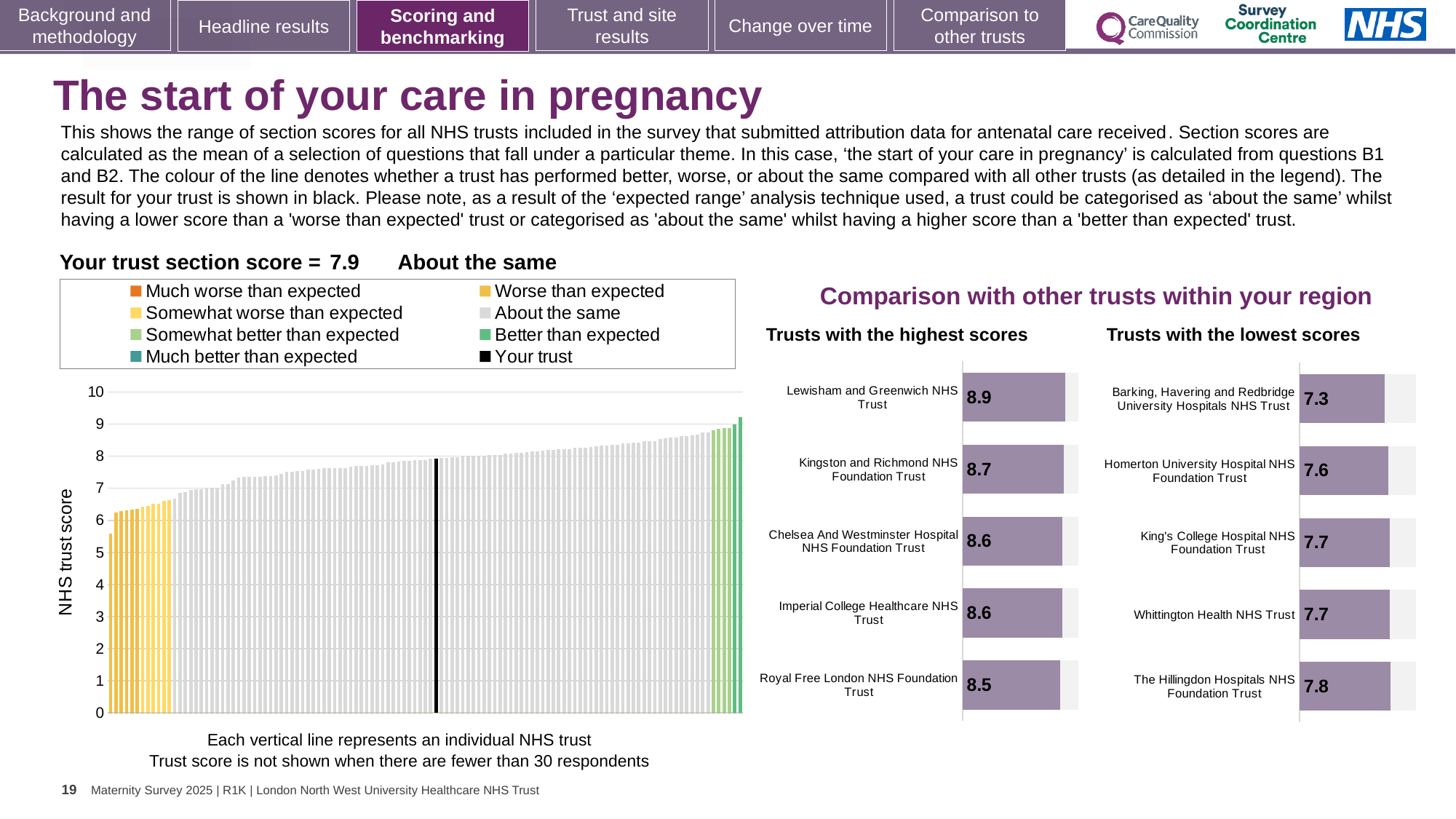
What kind of chart is the large chart on the left showing NHS trust scores? bar chart In the 'Trusts with the highest scores' chart, how many trusts are shown? 5 How many entries does the legend above the large chart on the left list? 8 In the 'Trusts with the highest scores' chart, what is the score for Lewisham and Greenwich NHS Trust? 8.9 In the large chart on the left, do the trust scores rise or fall from left to right? rise In the large chart on the left, what is the section score for your trust? 7.9 In the 'Trusts with the lowest scores' chart, which has the larger score: Homerton University Hospital NHS Foundation Trust or The Hillingdon Hospitals NHS Foundation Trust? The Hillingdon Hospitals NHS Foundation Trust In the 'Trusts with the lowest scores' chart, what is the score for Barking, Havering and Redbridge University Hospitals NHS Trust? 7.3 In the 'Trusts with the highest scores' chart, what is the difference between the scores of Lewisham and Greenwich NHS Trust and Royal Free London NHS Foundation Trust? 0.4 In the large chart on the left, what colour is used for your trust's bar? black In the 'Trusts with the highest scores' chart, which trust has the lowest score? Royal Free London NHS Foundation Trust In the 'Trusts with the lowest scores' chart, which trust has the highest score? The Hillingdon Hospitals NHS Foundation Trust